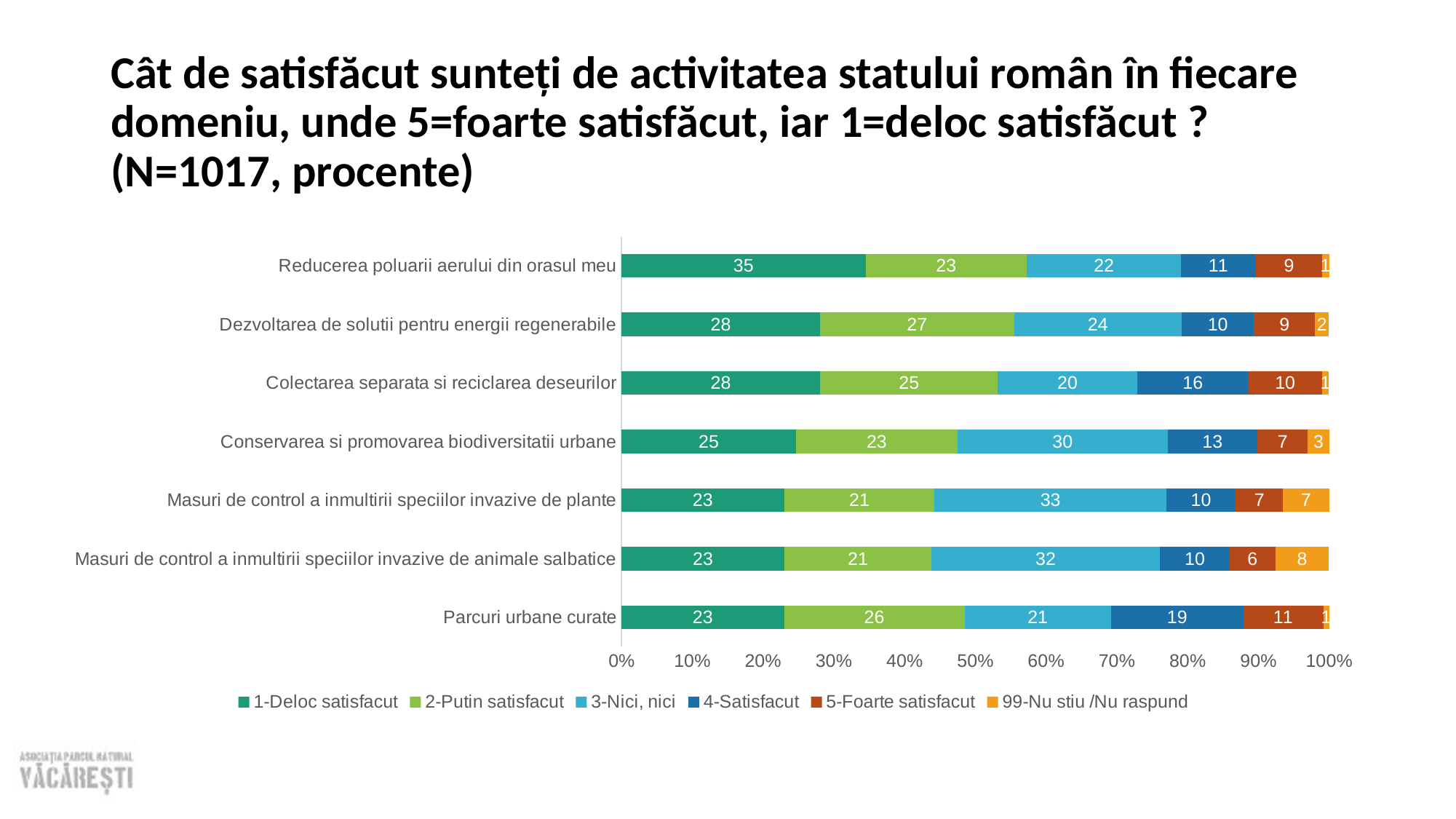
What is the total of the '1-Deloc satisfacut' and '2-Putin satisfacut' values for 'Conservarea si promovarea biodiversitatii urbane'? 48 How many categories (domains) are plotted on the chart? 7 What kind of chart is shown on the slide? Stacked bar chart Which is larger: the '2-Putin satisfacut' value for 'Dezvoltarea de solutii pentru energii regenerabile' or for 'Colectarea separata si reciclarea deseurilor'? Dezvoltarea de solutii pentru energii regenerabile What is the value of '1-Deloc satisfacut' for 'Reducerea poluarii aerului din orasul meu'? 35 How many series does the legend list? 6 Which category has the lowest value for '5-Foarte satisfacut'? Masuri de control a inmultirii speciilor invazive de animale salbatice Which category has the highest value for '1-Deloc satisfacut'? Reducerea poluarii aerului din orasul meu What is the value of '3-Nici, nici' for 'Masuri de control a inmultirii speciilor invazive de plante'? 33 What is the value of '99-Nu stiu /Nu raspund' for 'Masuri de control a inmultirii speciilor invazive de animale salbatice'? 8 What is the difference between the '4-Satisfacut' values for 'Parcuri urbane curate' and 'Reducerea poluarii aerului din orasul meu'? 8 What is the value of '4-Satisfacut' for 'Parcuri urbane curate'? 19